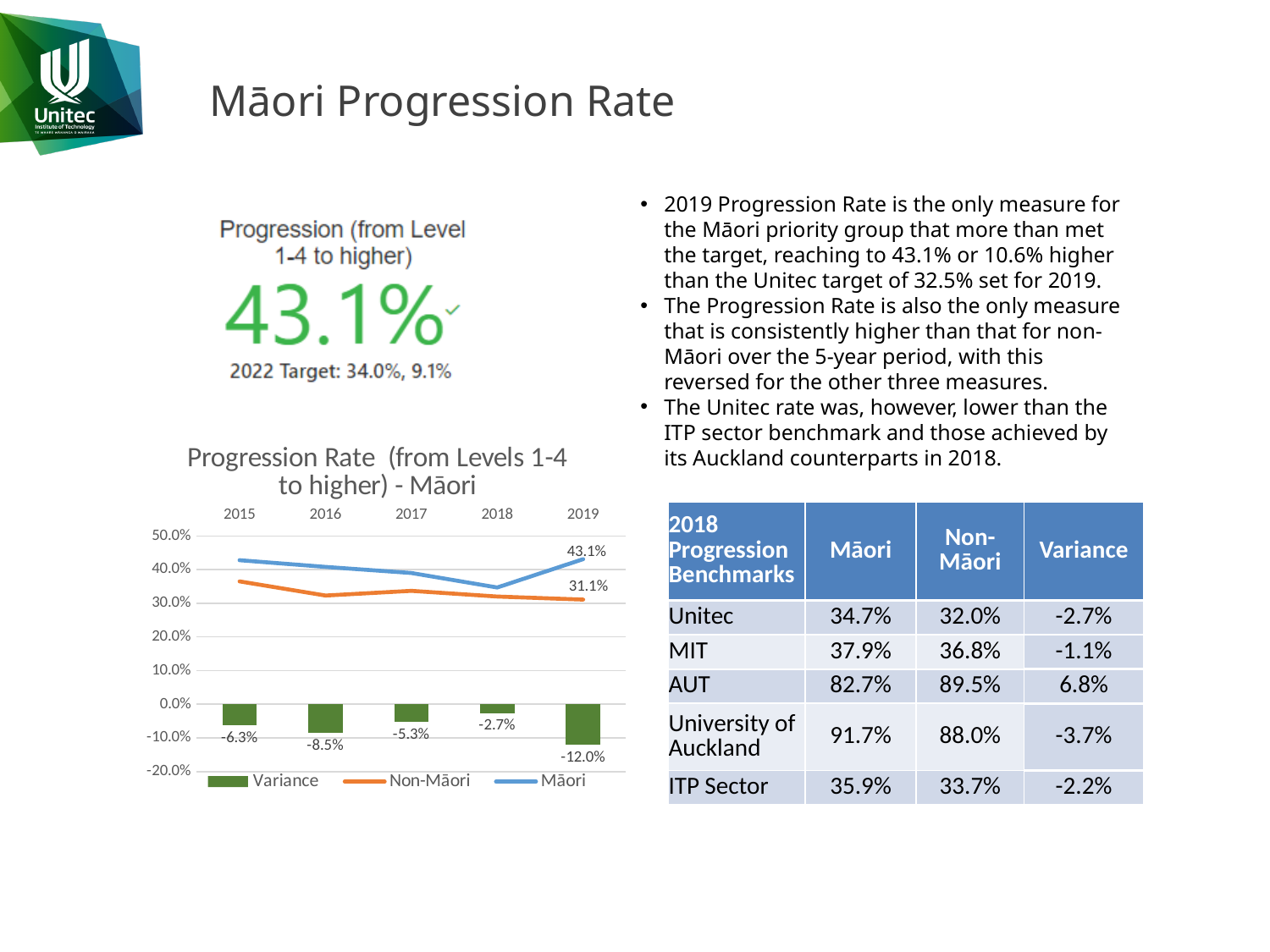
What kind of chart is the Progression Rate chart? Combined bar and line chart How many series does the legend of the Progression Rate chart list? 3 What is the Non-Māori progression rate for 2019 in the chart? 31.1% What is the Māori progression rate for 2019 in the chart? 43.1% What is the Variance value for 2017 in the Progression Rate chart? -5.3% In which year is the Variance bar highest (closest to zero)? 2018 In 2019, which is larger: the Māori or the Non-Māori progression rate? Māori In which year is the Variance bar lowest (most negative)? 2019 What is the difference between the Māori and Non-Māori progression rates in 2019? 12.0% How many years are shown on the x axis of the Progression Rate chart? 5 Is the Non-Māori progression rate for 2016 greater or less than 40.0%? less Is the Māori progression rate for 2015 greater or less than 40.0%? greater